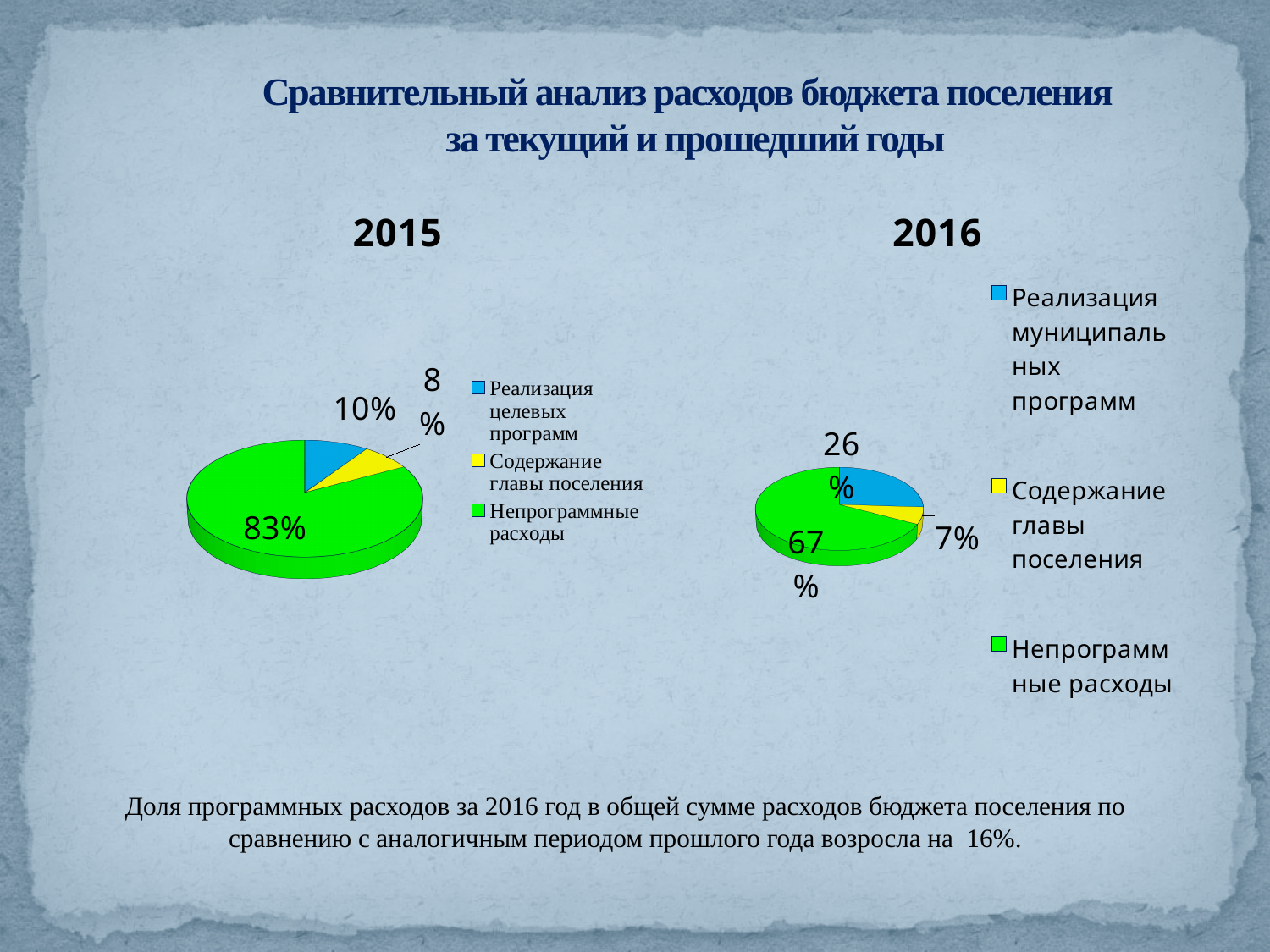
In the 2015 chart, which category has the smallest slice? Содержание главы поселения In the 2016 chart, what share is shown for Содержание главы поселения? 7% In the 2015 chart, what share is shown for Непрограммные расходы? 83% In the 2015 chart, what share is shown for Реализация целевых программ? 10% In the 2016 chart, what share is shown for Непрограммные расходы? 67% How many slices does the 2016 chart have? 3 In the 2015 chart, what share is shown for Содержание главы поселения? 8% What type of chart is the 2015 chart? Pie chart In the 2016 chart, what share is shown for Реализация муниципальных программ? 26% Which is larger: the Реализация целевых программ share in the 2015 chart or the Реализация муниципальных программ share in the 2016 chart? 2016 (26%) What is the difference between the Непрограммные расходы share in the 2015 chart and in the 2016 chart? 16% In the 2016 chart, which category has the largest slice? Непрограммные расходы